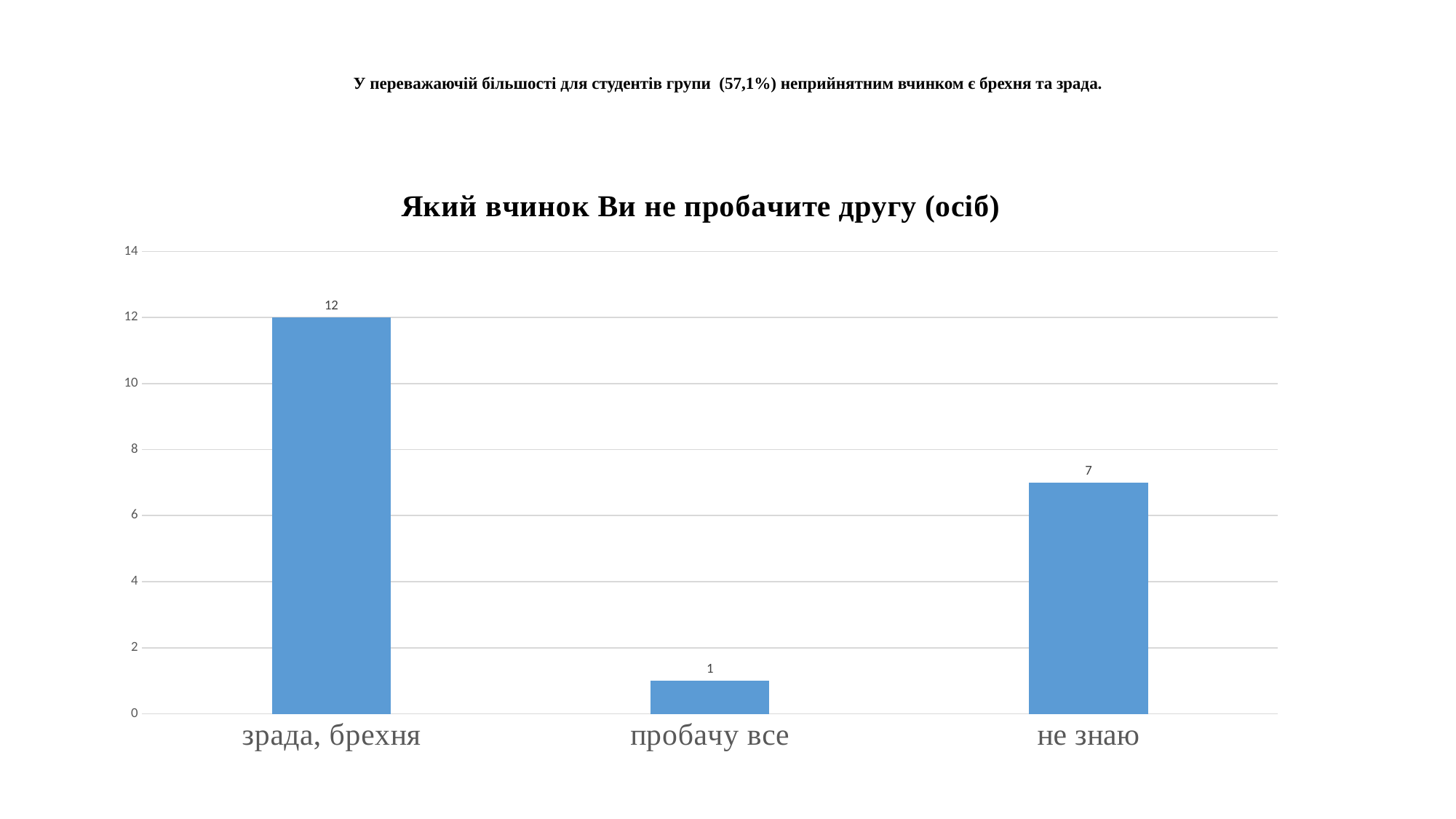
Which category has the lowest value? пробачу все Is the value for "не знаю" greater or less than 8? less What is the difference between the values for "не знаю" and "пробачу все"? 6 What is the difference between the values for "зрада, брехня" and "не знаю"? 5 Which category has the highest value? зрада, брехня What is the value for "зрада, брехня"? 12 What kind of chart is shown on the slide? bar chart What is the title of the chart? Який вчинок Ви не пробачите другу (осіб) What is the value for "не знаю"? 7 Which is larger, the value for "не знаю" or the value for "пробачу все"? не знаю What is the value for "пробачу все"? 1 How many categories are shown on the x axis? 3